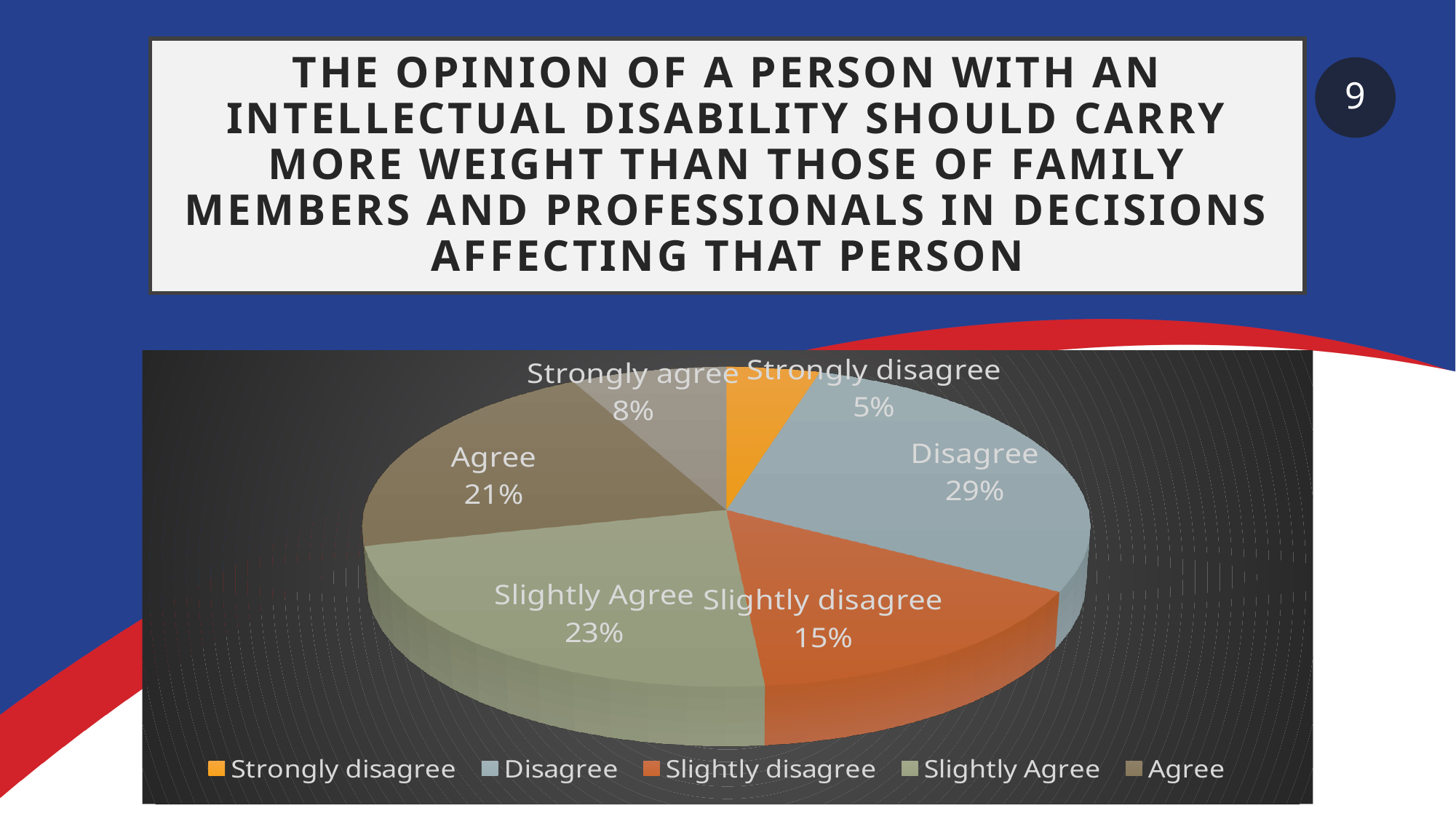
How many slices does the pie chart have? 6 Which colour represents Slightly disagree in the pie chart? orange What percentage of respondents chose Strongly disagree? 5% Which response has the largest share of the pie? Disagree What percentage of respondents chose Disagree? 29% Which is larger, the share for Slightly Agree or the share for Agree? Slightly Agree What percentage of respondents chose Strongly agree? 8% Which response has the smallest share of the pie? Strongly disagree What percentage of respondents chose Slightly Agree? 23% What percentage of respondents chose Agree? 21% What is the difference in percentage points between Disagree and Slightly disagree? 14 What kind of chart is shown on the slide? pie chart